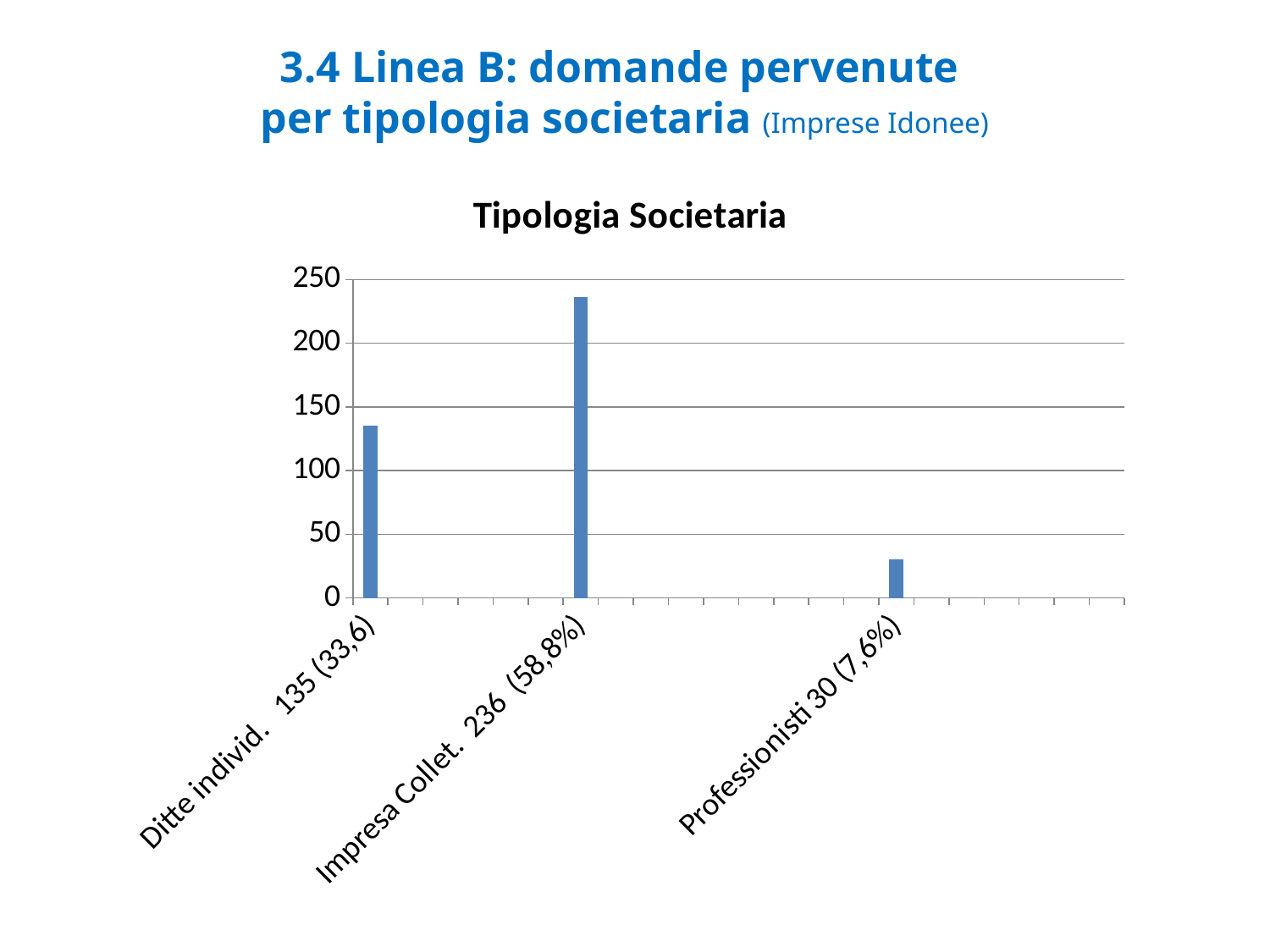
What is the value for Ditte individ.? 135 What type of chart is shown on the slide? bar chart Which is larger, the value for Ditte individ. or the value for Professionisti? Ditte individ. What percentage is shown in the label for Impresa Collet.? 58,8% How many categories are plotted in the chart? 3 What is the title of the chart? Tipologia Societaria What is the value for Impresa Collet.? 236 Is the value for Professionisti greater or less than 50? less What is the value for Professionisti? 30 Which category has the lowest value? Professionisti What is the difference between the values for Impresa Collet. and Ditte individ.? 101 Which category has the highest value? Impresa Collet.